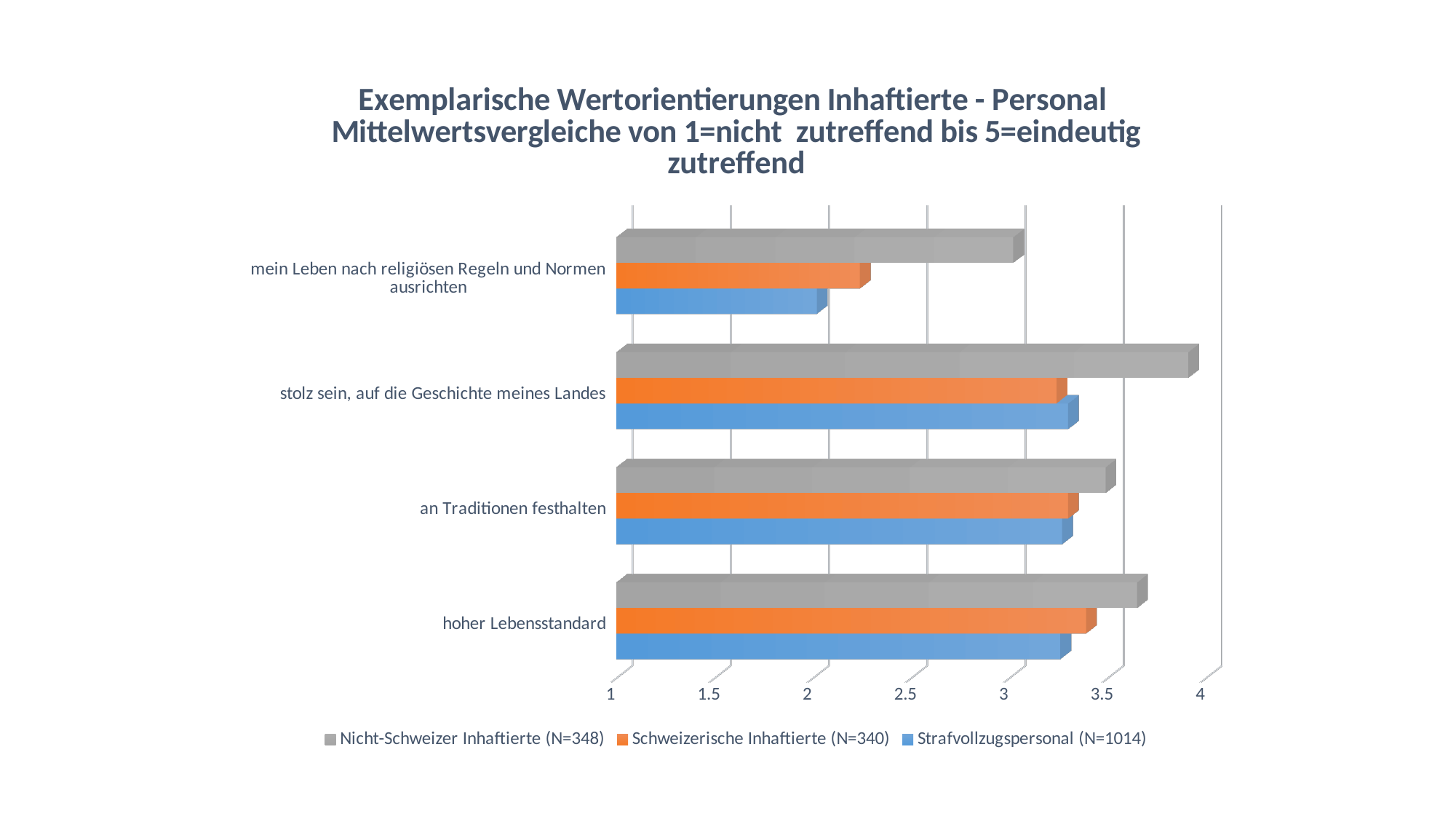
For which category is the value for Nicht-Schweizer Inhaftierte (N=348) highest? stolz sein, auf die Geschichte meines Landes How many series does the legend list? 3 Is the value for Nicht-Schweizer Inhaftierte (N=348) for 'hoher Lebensstandard' greater or less than 3.5? greater Is the value for Schweizerische Inhaftierte (N=340) for 'mein Leben nach religiösen Regeln und Normen ausrichten' greater or less than 2.5? less What sample size (N) does the legend give for Strafvollzugspersonal? N=1014 How many categories are shown on the vertical axis of the chart? 4 For which category is the value for Nicht-Schweizer Inhaftierte (N=348) lowest? mein Leben nach religiösen Regeln und Normen ausrichten For 'mein Leben nach religiösen Regeln und Normen ausrichten', which series has the larger value: Nicht-Schweizer Inhaftierte (N=348) or Schweizerische Inhaftierte (N=340)? Nicht-Schweizer Inhaftierte (N=348) What kind of chart is shown on the slide? bar chart For 'stolz sein, auf die Geschichte meines Landes', which series has the larger value: Nicht-Schweizer Inhaftierte (N=348) or Strafvollzugspersonal (N=1014)? Nicht-Schweizer Inhaftierte (N=348) Is the value for Nicht-Schweizer Inhaftierte (N=348) for 'stolz sein, auf die Geschichte meines Landes' greater or less than 3.5? greater